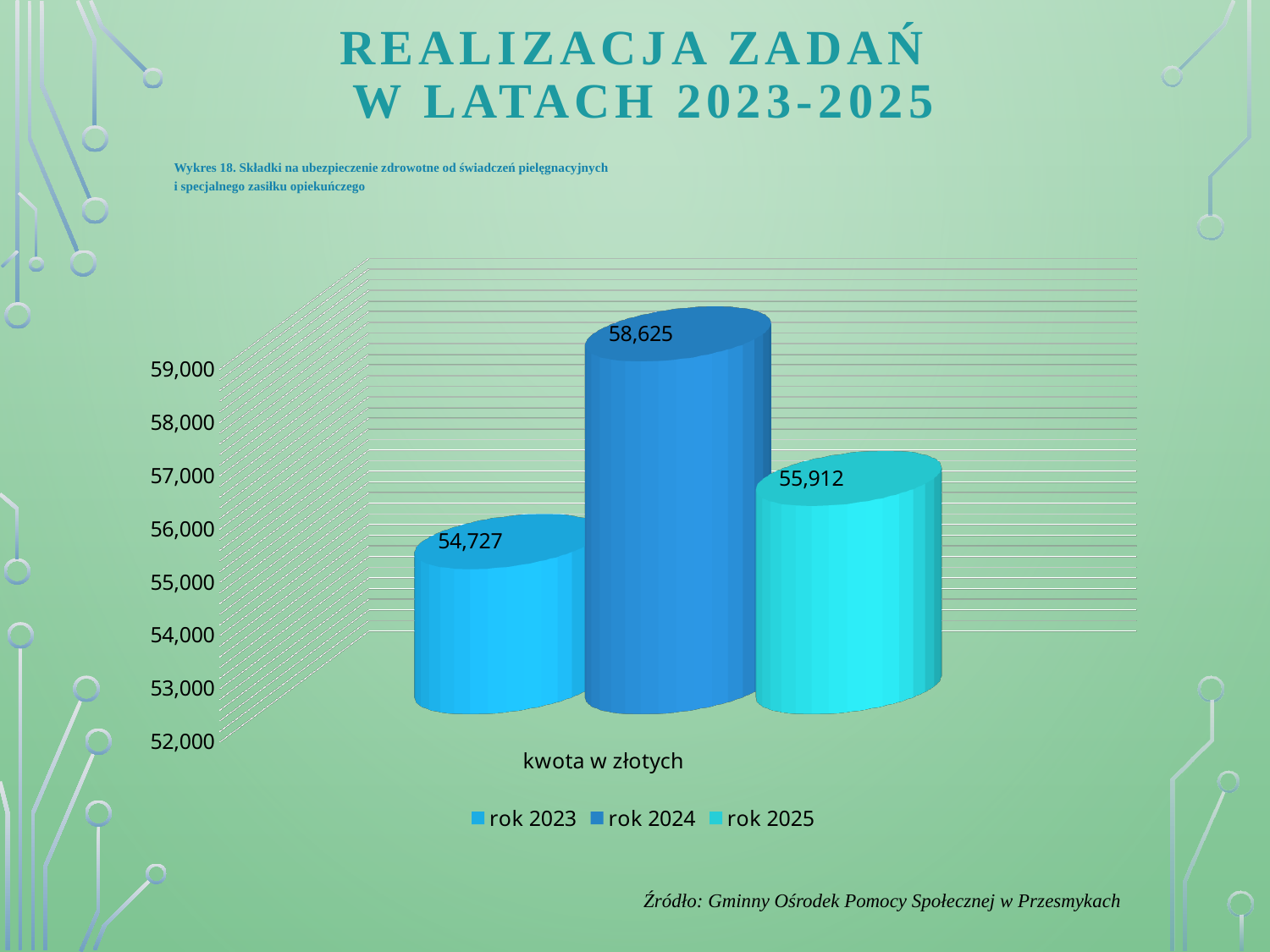
What is the label of the category on the x axis? kwota w złotych What is the difference between the values for rok 2024 and rok 2023? 3,898 Which year has the lowest value? rok 2023 What is the value for rok 2025? 55,912 What is the difference between the values for rok 2025 and rok 2023? 1,185 What kind of chart is shown on the slide? bar chart Is the value for rok 2024 greater or less than 58,000? greater What is the value for rok 2023? 54,727 How many series does the legend list? 3 Which is larger, the value for rok 2025 or the value for rok 2023? rok 2025 What is the value for rok 2024? 58,625 Which year has the highest value? rok 2024